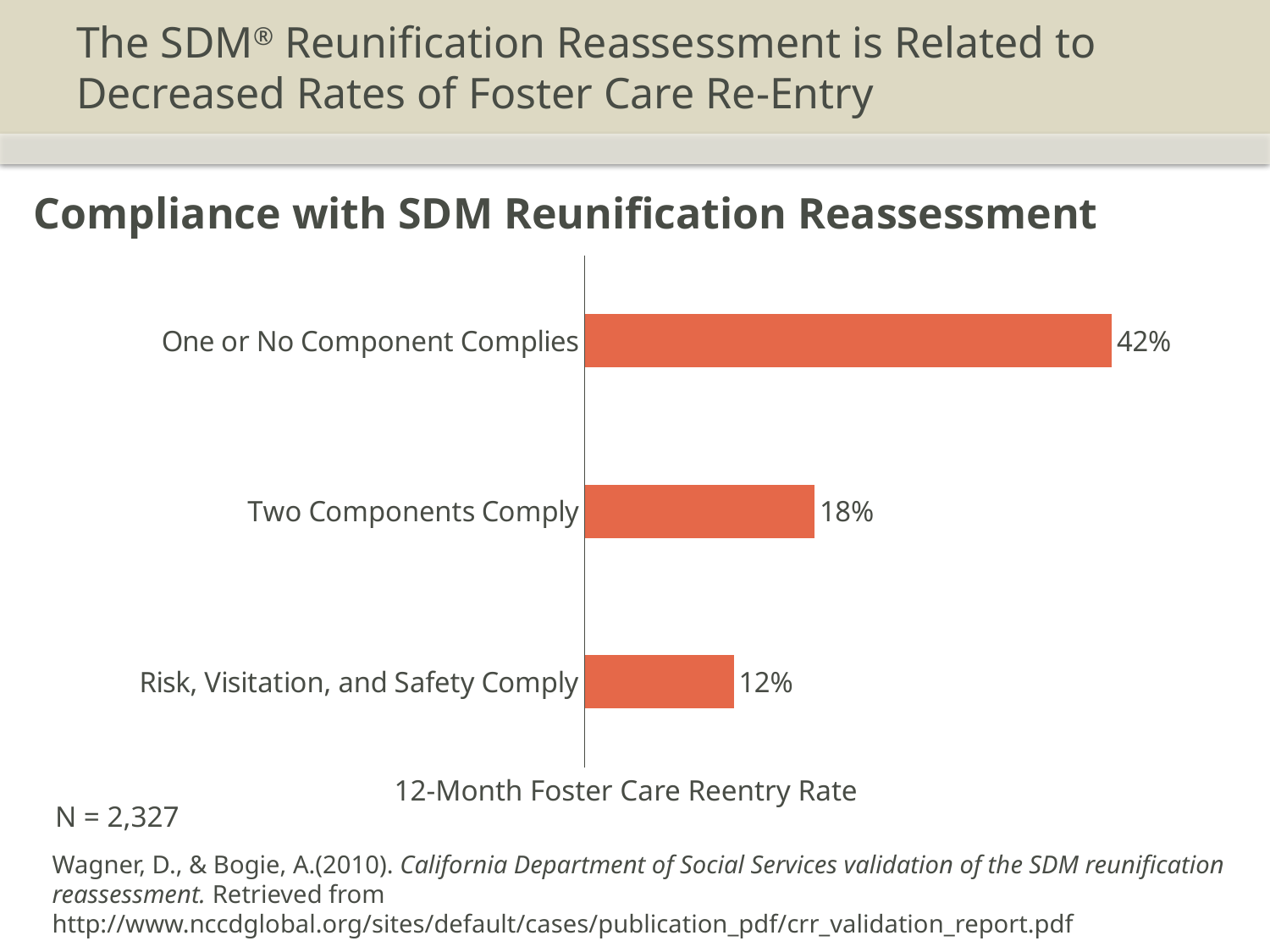
What is the difference in reentry rate between 'Two Components Comply' and 'Risk, Visitation, and Safety Comply'? 6% Which category has the highest 12-month foster care reentry rate? One or No Component Complies Which category has the lowest 12-month foster care reentry rate? Risk, Visitation, and Safety Comply What is the title of the chart? Compliance with SDM Reunification Reassessment How many categories are shown in the chart? 3 What is the 12-month foster care reentry rate for 'Risk, Visitation, and Safety Comply'? 12% What is the difference in reentry rate between 'One or No Component Complies' and 'Risk, Visitation, and Safety Comply'? 30% What is the 12-month foster care reentry rate for 'One or No Component Complies'? 42% What type of chart is shown on the slide? Bar chart What is the sample size (N) noted on the slide? N = 2,327 What is the 12-month foster care reentry rate for 'Two Components Comply'? 18% Which has a higher reentry rate: 'Two Components Comply' or 'Risk, Visitation, and Safety Comply'? Two Components Comply